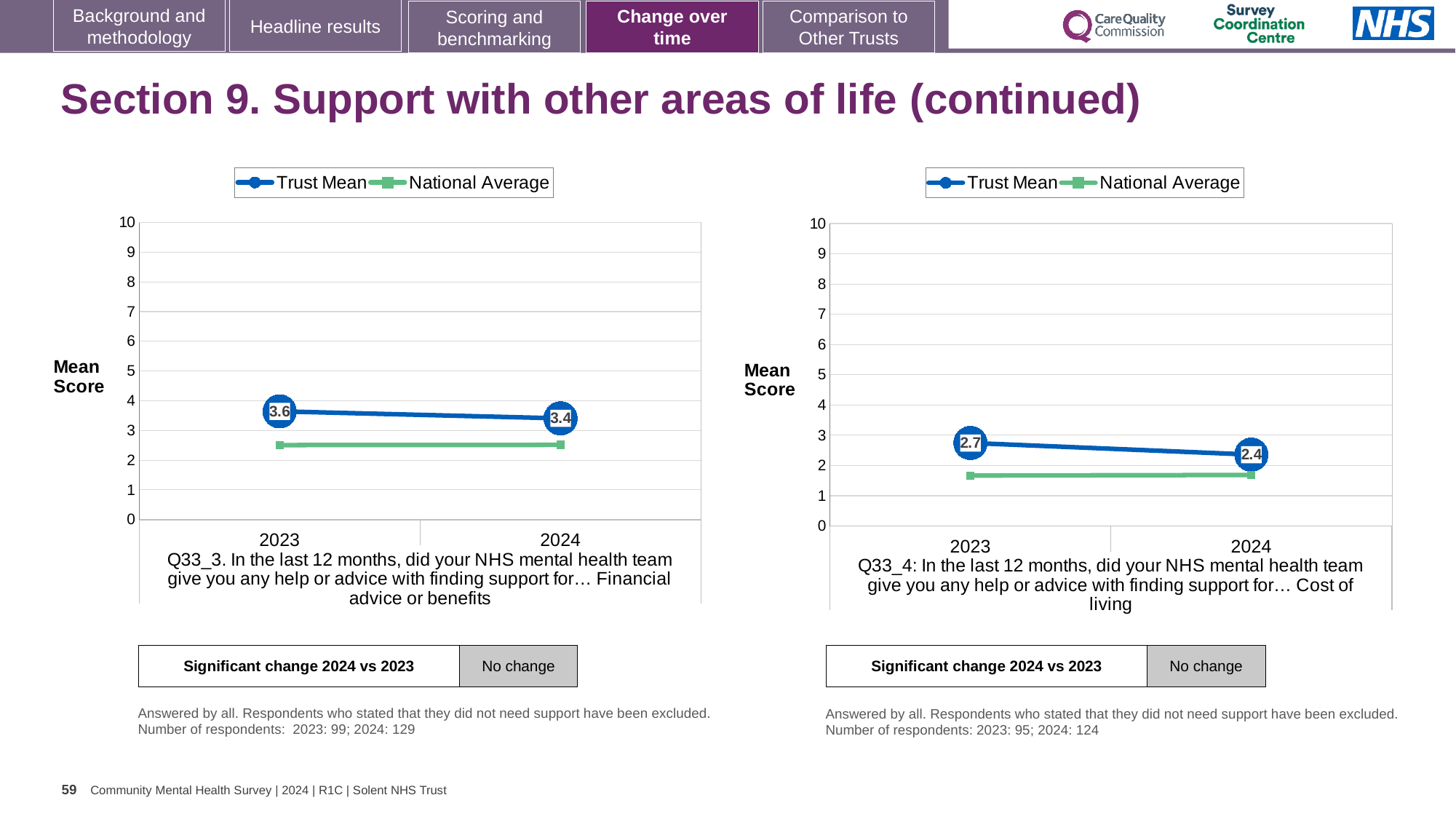
On the right chart (Q33_4, Cost of living), what is the Trust Mean score for 2024? 2.4 How many series does the legend of the right chart (Q33_4) list? 2 On the left chart (Q33_3), by how much did the Trust Mean change from 2023 to 2024? 0.2 What kind of chart is the left chart (Q33_3)? line chart On the right chart (Q33_4), is the National Average value for 2023 greater or less than 2? less On the left chart (Q33_3, Financial advice or benefits), what is the Trust Mean score for 2024? 3.4 On the left chart (Q33_3), does the Trust Mean rise or fall from 2023 to 2024? fall On the left chart (Q33_3, Financial advice or benefits), what is the Trust Mean score for 2023? 3.6 On the right chart (Q33_4), is the Trust Mean for 2023 higher or lower than the Trust Mean for 2024? higher On the right chart (Q33_4, Cost of living), what is the Trust Mean score for 2023? 2.7 On the left chart (Q33_3), is the National Average value for 2024 greater or less than 3? less On the right chart (Q33_4), by how much did the Trust Mean change from 2023 to 2024? 0.3